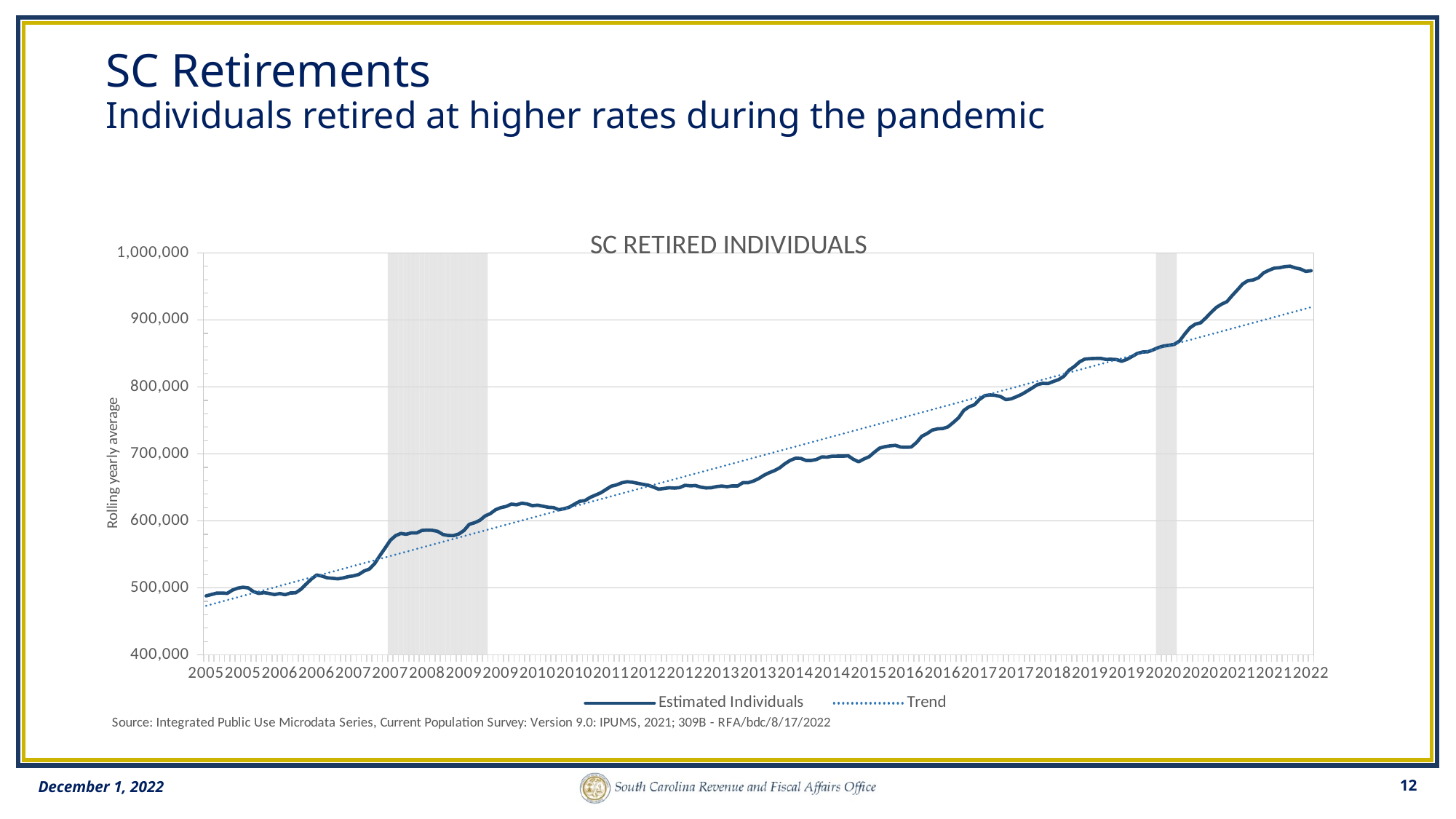
At the end of the chart in 2022, which line is higher, Estimated Individuals or Trend? Estimated Individuals Do the Estimated Individuals values generally rise or fall from 2005 to 2022? Rise In which year does the Estimated Individuals line reach its lowest point? 2005 Is the Estimated Individuals value in 2019 greater or less than 800,000? greater How many series does the legend of the SC RETIRED INDIVIDUALS chart list? 2 Is the Estimated Individuals value in 2022 greater or less than 900,000? greater Is the Estimated Individuals value in 2010 greater or less than 700,000? less Which is larger, the Estimated Individuals value in 2005 or in 2022? 2022 What is the label on the vertical axis of the chart? Rolling yearly average What is the title of the chart on the slide? SC RETIRED INDIVIDUALS What kind of chart is shown on the slide? Line chart